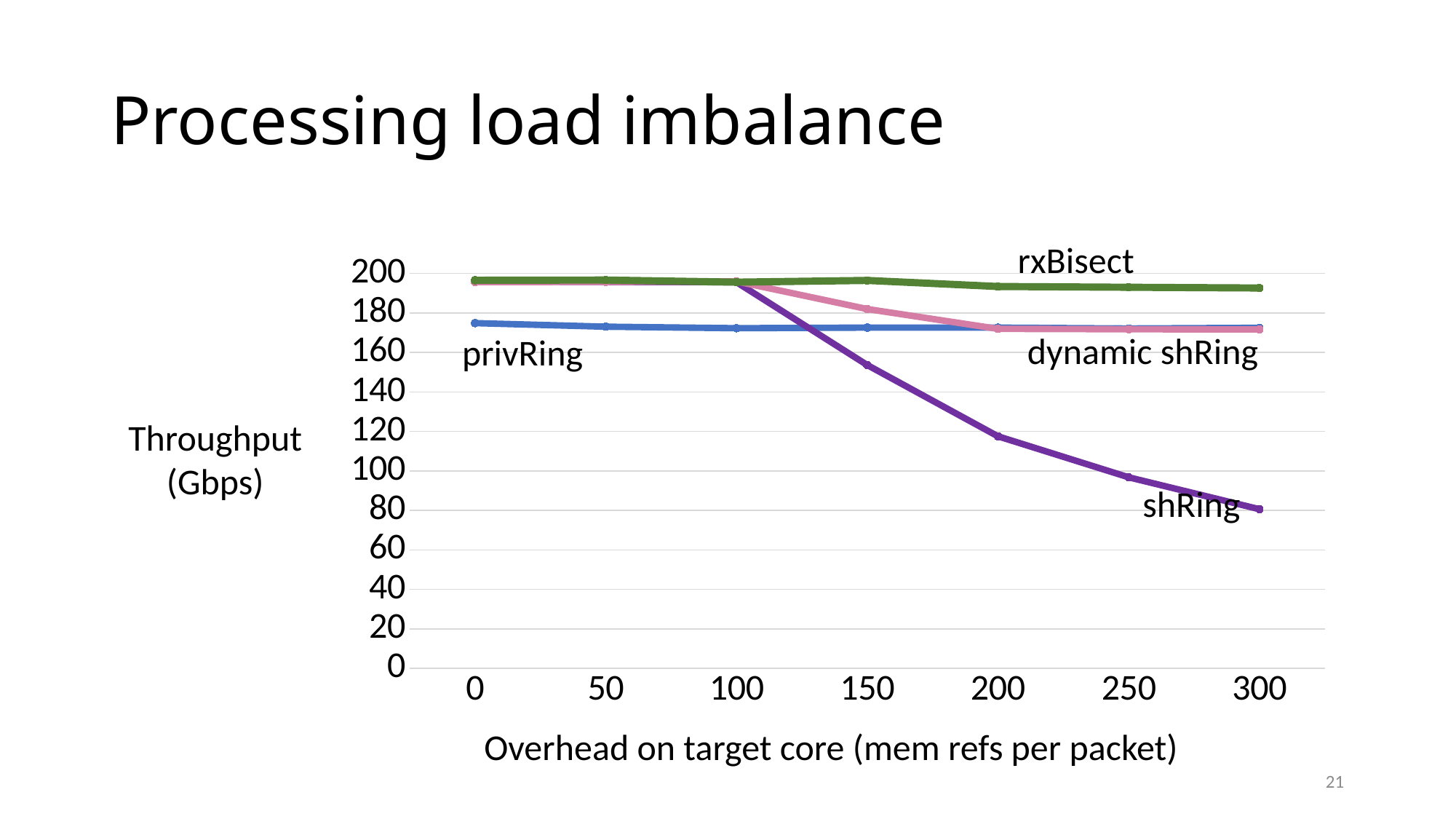
Is the throughput of privRing at an overhead of 0 greater or less than 180 Gbps? less What is the label of the x axis? Overhead on target core (mem refs per packet) Does the throughput of shRing rise or fall as the overhead on the target core increases? fall How many x-axis points (overhead values) are plotted for each series? 7 What kind of chart is shown on the slide? line chart Is the throughput of rxBisect at an overhead of 0 greater or less than 180 Gbps? greater Is the throughput of shRing at an overhead of 150 greater or less than 140 Gbps? greater Which series has the lowest throughput at an overhead of 300 mem refs per packet? shRing Which series has the highest throughput at an overhead of 300 mem refs per packet? rxBisect How many series are plotted on the chart? 4 At an overhead of 200, which series has higher throughput: rxBisect or shRing? rxBisect